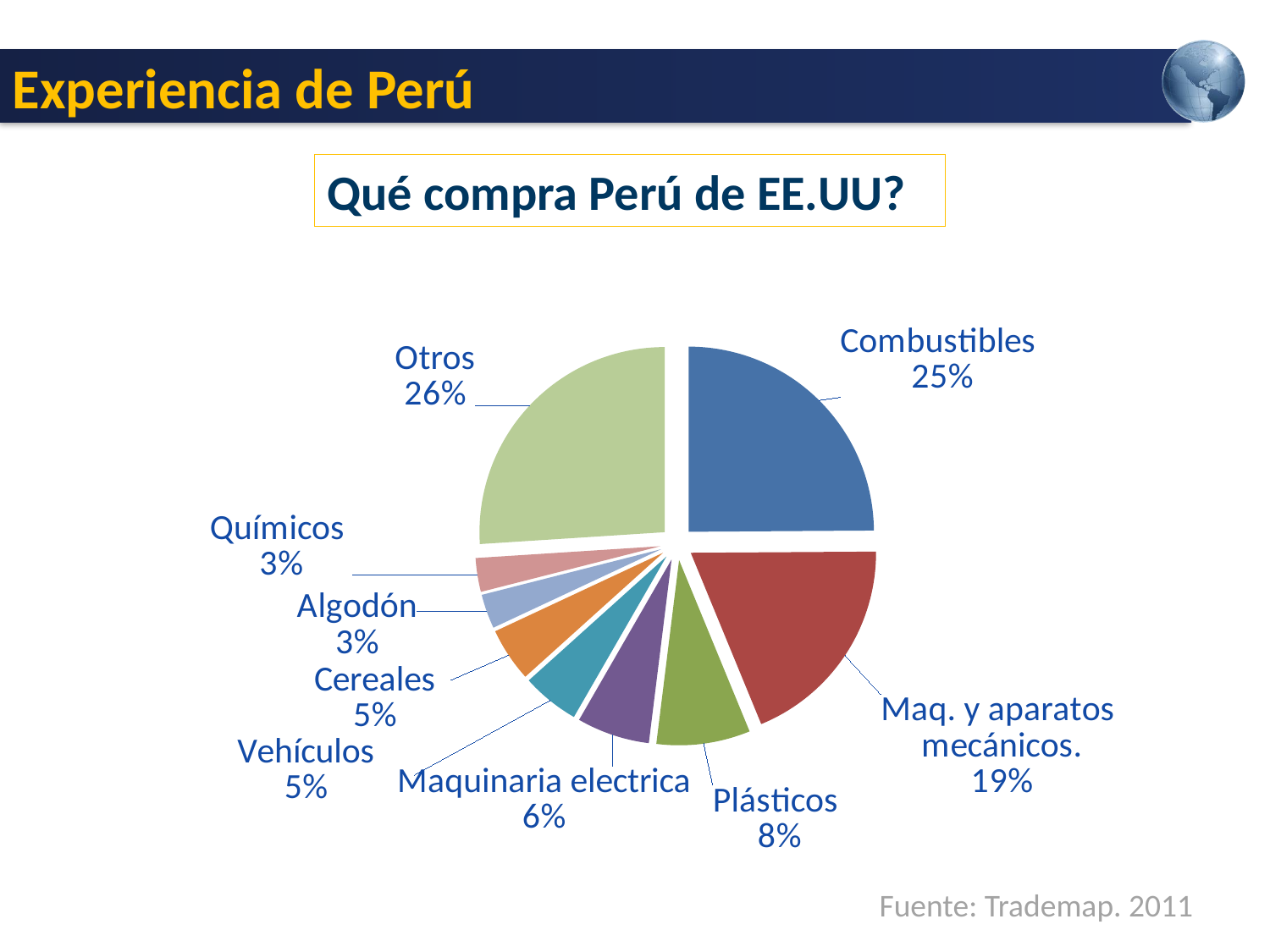
What share of the pie does Combustibles represent? 25% What is the difference in percentage points between Combustibles and Maq. y aparatos mecánicos? 6 What is the value shown for Plásticos? 8% What is the value shown for Otros? 26% What is the value shown for Maquinaria electrica? 6% How many slices does the pie chart have? 9 Which is larger, Plásticos or Maquinaria electrica? Plásticos What is the value shown for Maq. y aparatos mecánicos? 19% Which slice of the pie is the largest? Otros What is the title of the chart? Qué compra Perú de EE.UU? What kind of chart is shown on the slide? pie chart What source is cited for the chart? Trademap. 2011